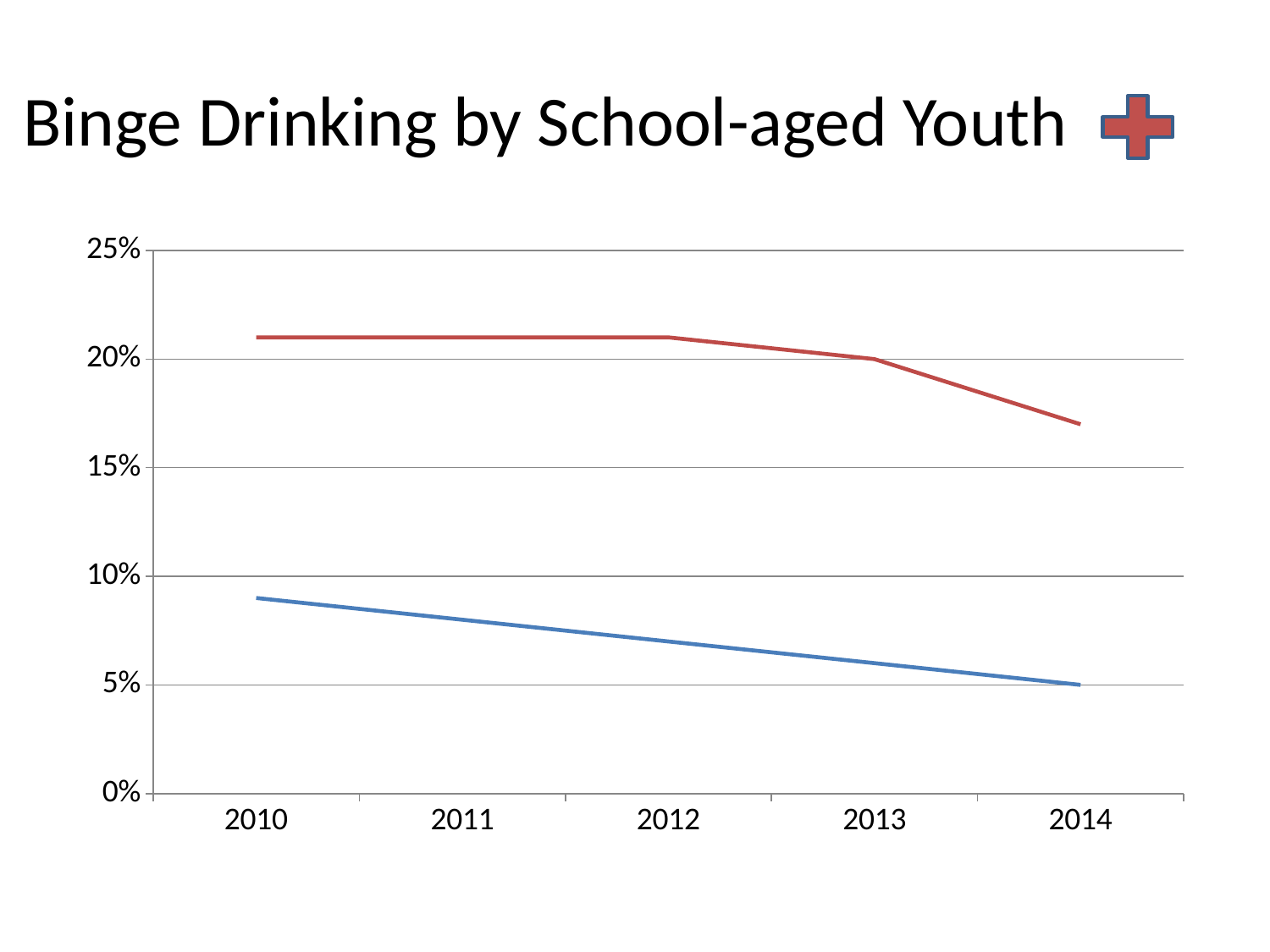
What is the value of the red line in 2013? 20% What is the title of the chart on the slide? Binge Drinking by School-aged Youth In which year does the red line reach its lowest value? 2014 Is the value of the blue line in 2012 greater or less than 5%? greater Is the value of the red line in 2010 greater or less than 20%? greater Is the value of the blue line in 2010 greater or less than 10%? less Which line has the higher value in 2014, the red line or the blue line? the red line Does the blue line rise or fall from 2010 to 2014? fall How many years are shown along the x axis of the chart? 5 What is the value of the blue line in 2014? 5% What kind of chart is shown on the slide? line chart